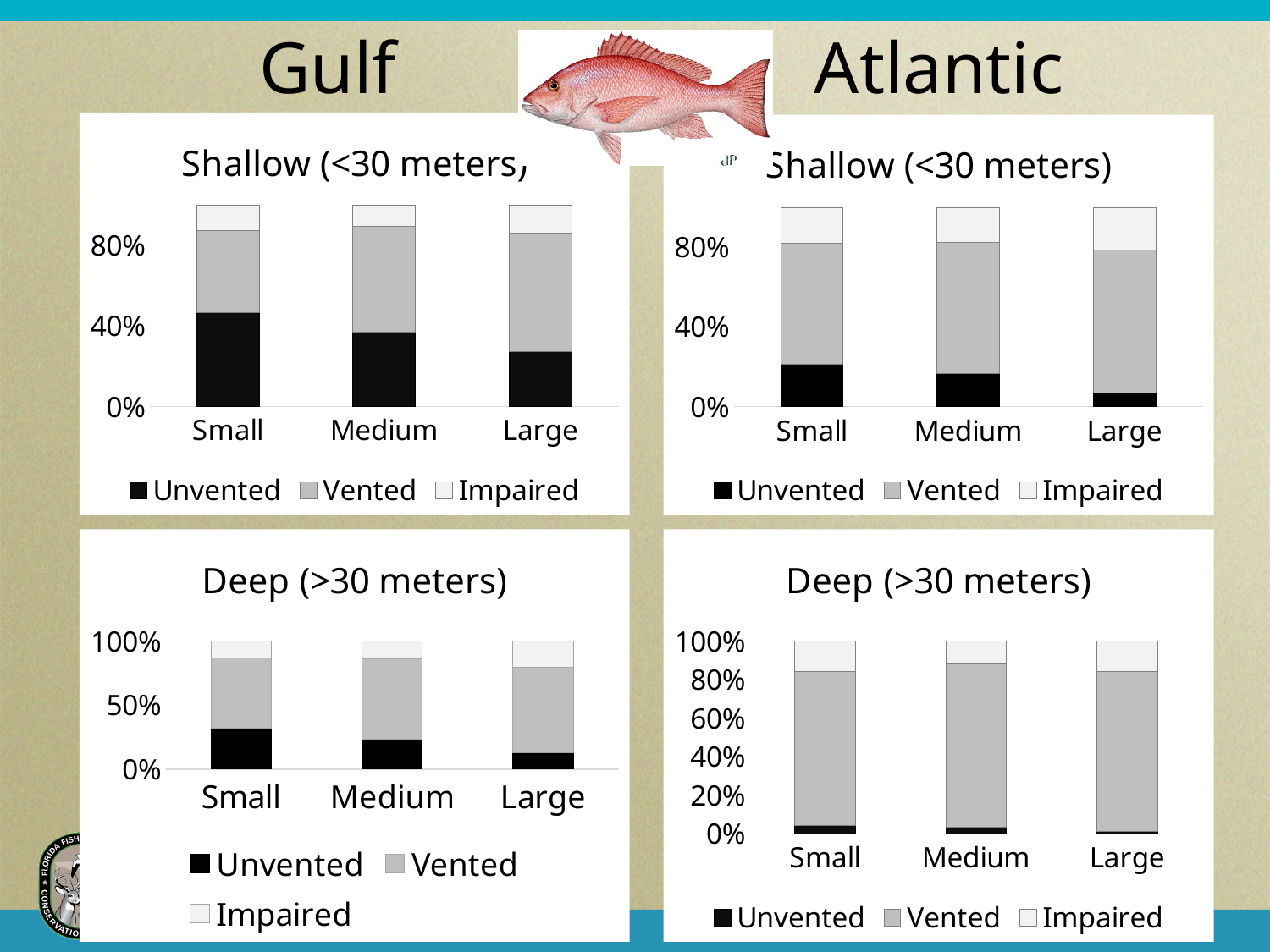
How many series does the legend list in the Atlantic Deep (>30 meters) chart? 3 In the Gulf Deep (>30 meters) chart, which is larger, the Unvented value for Small or for Large? Small In the Atlantic Shallow (<30 meters) chart, which size category has the lowest Unvented value? Large What kind of chart is the Gulf Shallow (<30 meters) chart? stacked bar chart In the Gulf Shallow (<30 meters) chart, is the Unvented value for Small greater or less than 40%? greater How many size categories are shown on the x axis of the Gulf Deep (>30 meters) chart? 3 In the Atlantic Deep (>30 meters) chart, is the Unvented value for Small greater or less than 20%? less In the Gulf Deep (>30 meters) chart, is the Unvented value for Small greater or less than 50%? less In the Atlantic Shallow (<30 meters) chart, which size category has the highest Unvented value? Small In the Gulf Shallow (<30 meters) chart, does the Unvented value rise or fall from Small to Large? fall Which series is shown in black in the Atlantic Shallow (<30 meters) chart? Unvented